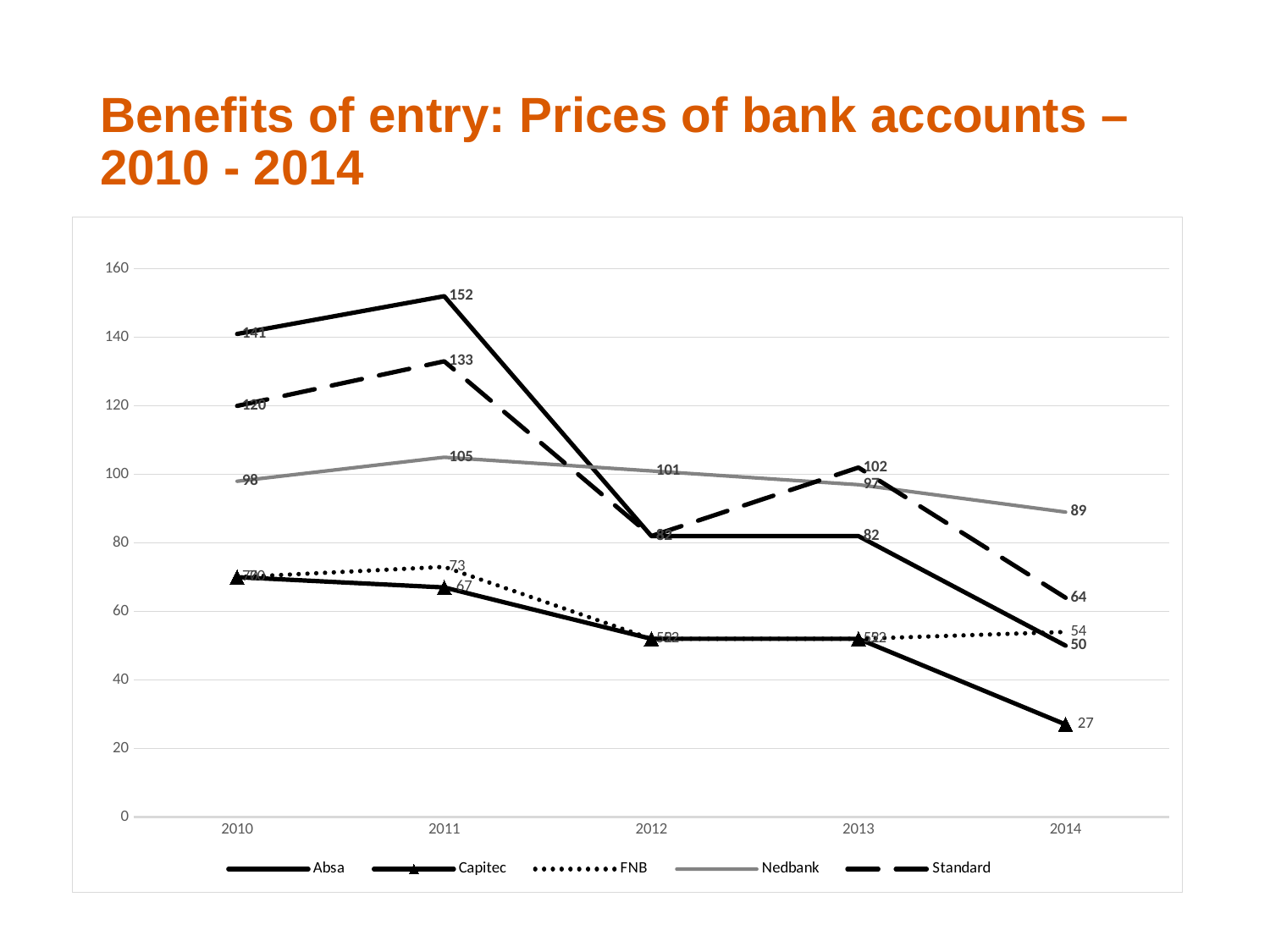
How many series does the legend list? 5 Does the Nedbank line rise or fall from 2011 to 2014? Fall Which bank has the highest value in 2011? Absa Which bank has the lowest value in 2014? Capitec What is the difference between Absa's value in 2011 and its value in 2014? 102 What is the value for Capitec in 2014? 27 What is the value for Absa in 2011? 152 What is the value for Standard in 2013? 102 What is the value for Nedbank in 2014? 89 In 2014, which is larger: the value for Standard or the value for Nedbank? Nedbank What kind of chart is shown on the slide? Line chart How many years are shown on the x axis? 5